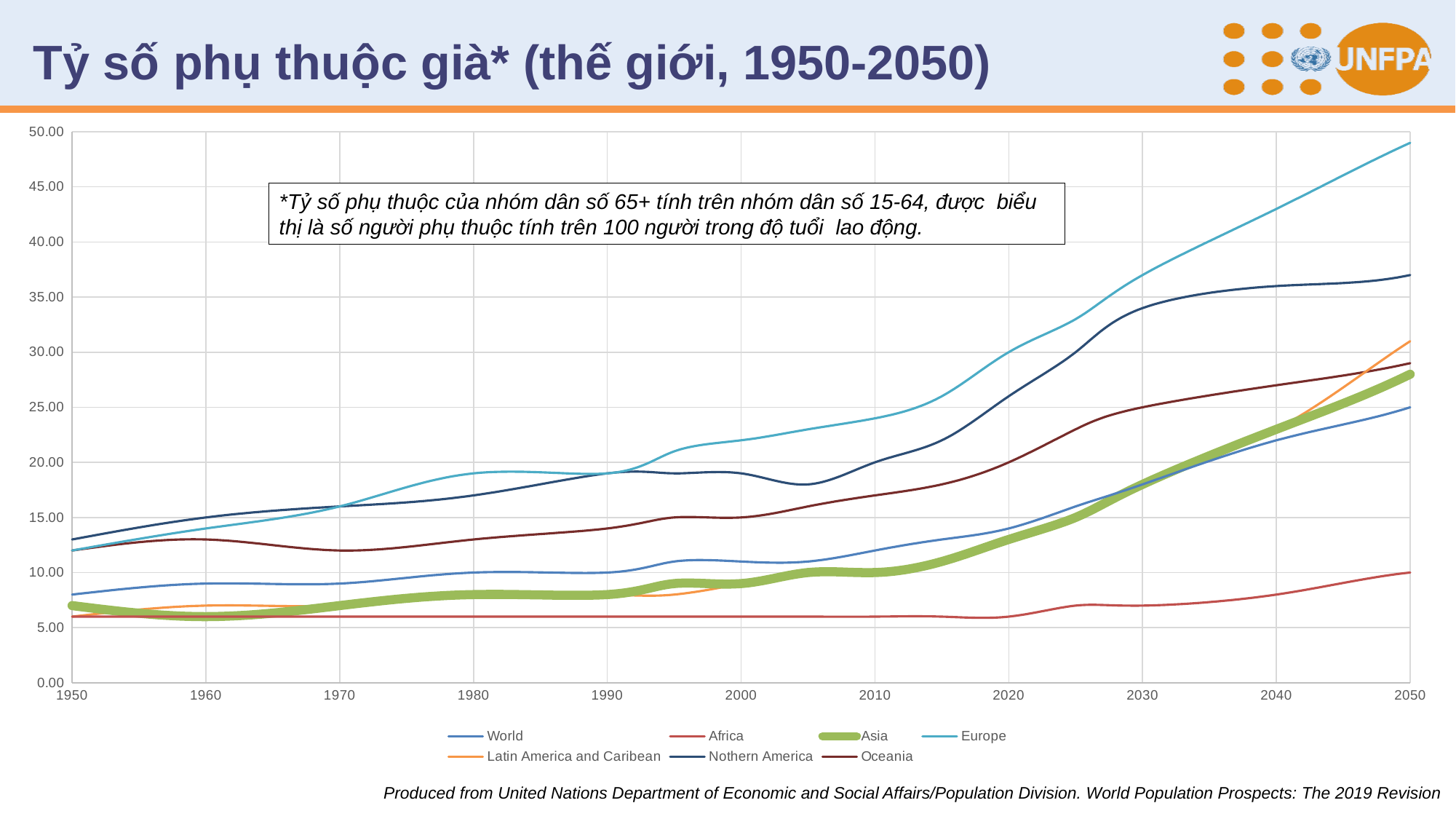
Which region has the highest value in 2050? Europe Which is larger in 2000, the value for World or the value for Africa? World Is the value for Asia in 1990 greater or less than 10? less Is the value for Africa in 2050 greater or less than 15? less Which series is drawn with the thick green line? Asia Does the value for Europe rise or fall from 1950 to 2050? rise Is the value for Europe in 2050 greater or less than 45? greater What kind of chart is shown on the slide? line chart Which is larger in 2050, the value for Europe or the value for Asia? Europe How many series does the legend list? 7 Which region has the lowest value in 2050? Africa